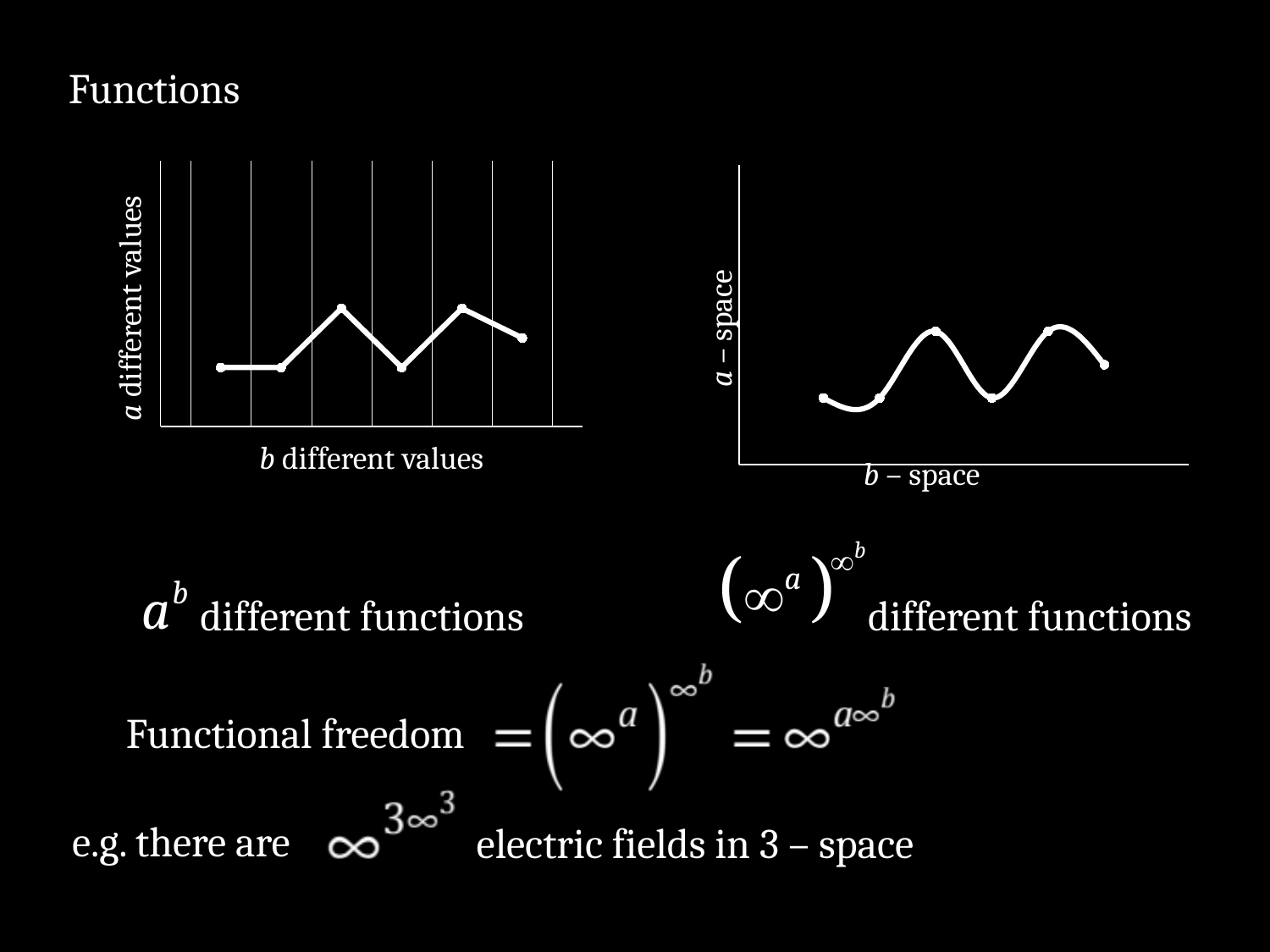
On the left chart, is the first point from the left higher or lower than the third point from the left? lower What is the label on the horizontal axis of the left chart? b different values How many data points are plotted on the right chart? 6 On the right chart, is the last point on the right higher or lower than the point immediately before it? lower What kind of chart is the chart on the left of the slide? line chart What is the label on the vertical axis of the right chart? a – space What kind of chart is the chart on the right of the slide? line chart How many data points are plotted on the left chart? 6